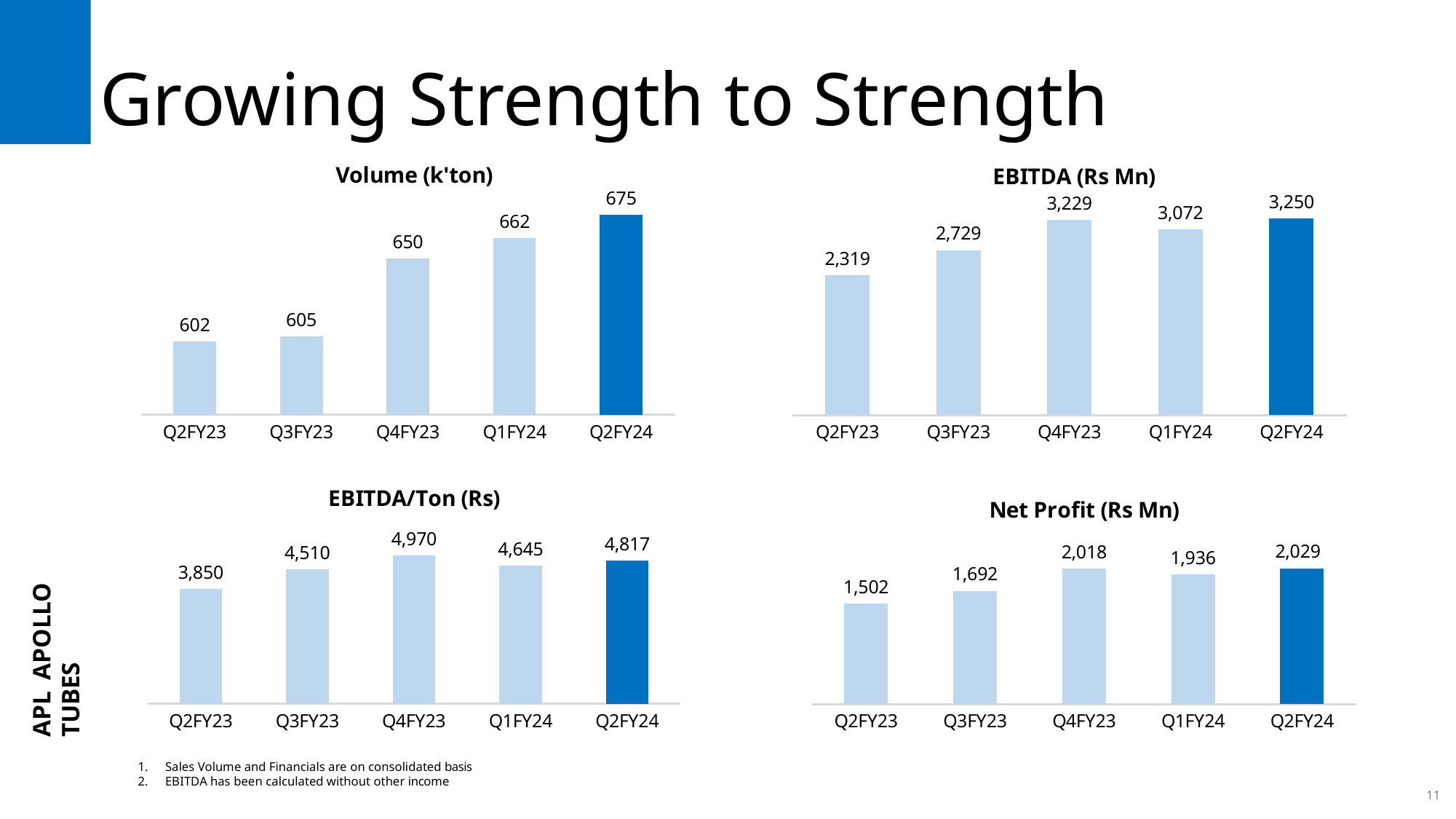
How many charts are shown on the slide? 4 How many quarters are shown in the EBITDA/Ton (Rs) chart? 5 In the Net Profit (Rs Mn) chart, what is the difference between Q2FY24 and Q1FY24? 93 In the Net Profit (Rs Mn) chart, which quarter has the lowest value? Q2FY23 In the EBITDA (Rs Mn) chart, which is larger, Q4FY23 or Q1FY24? Q4FY23 In the EBITDA (Rs Mn) chart, what is the value for Q3FY23? 2,729 In the EBITDA/Ton (Rs) chart, which quarter has the highest value? Q4FY23 In the Volume (k'ton) chart, what is the value for Q2FY24? 675 In the EBITDA/Ton (Rs) chart, what is the value for Q1FY24? 4,645 What kind of chart is the Net Profit (Rs Mn) chart? Bar chart In the Volume (k'ton) chart, do the values generally rise or fall from Q2FY23 to Q2FY24? Rise In the Volume (k'ton) chart, what is the difference between Q2FY24 and Q2FY23? 73